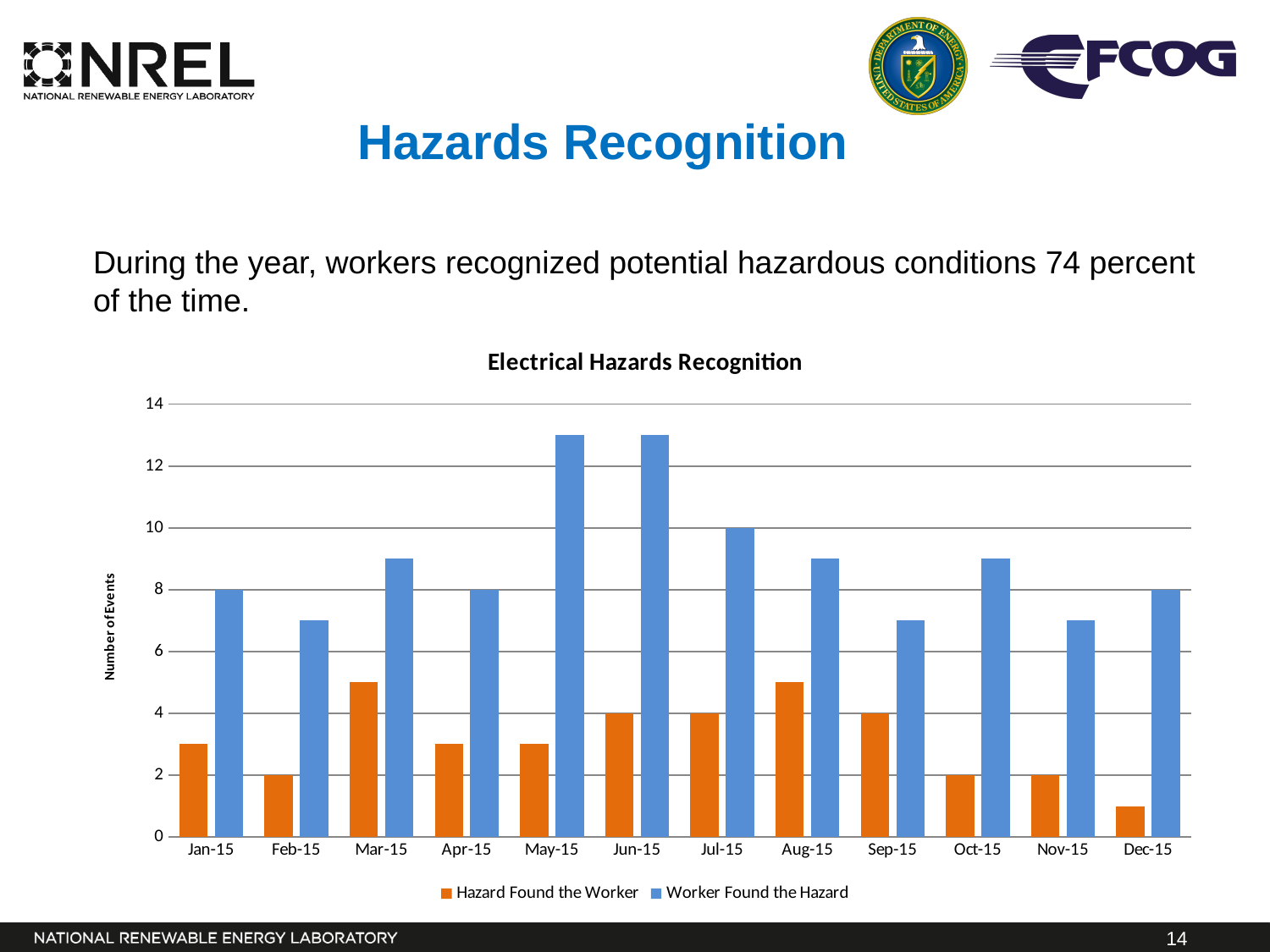
How many series does the legend list? 2 Which month has the lowest value for Hazard Found the Worker? Dec-15 What is the value for Worker Found the Hazard in Jul-15? 10 Is the value for Hazard Found the Worker in Mar-15 greater or less than 4? greater What is the difference between Worker Found the Hazard and Hazard Found the Worker in Jul-15? 6 What is the value for Worker Found the Hazard in Dec-15? 8 What is the value for Hazard Found the Worker in Feb-15? 2 What is the title of the chart? Electrical Hazards Recognition Is the value for Worker Found the Hazard in May-15 greater or less than 12? greater How many months are shown on the x axis? 12 What type of chart is shown on the slide? bar chart In Jul-15, which is larger: Hazard Found the Worker or Worker Found the Hazard? Worker Found the Hazard